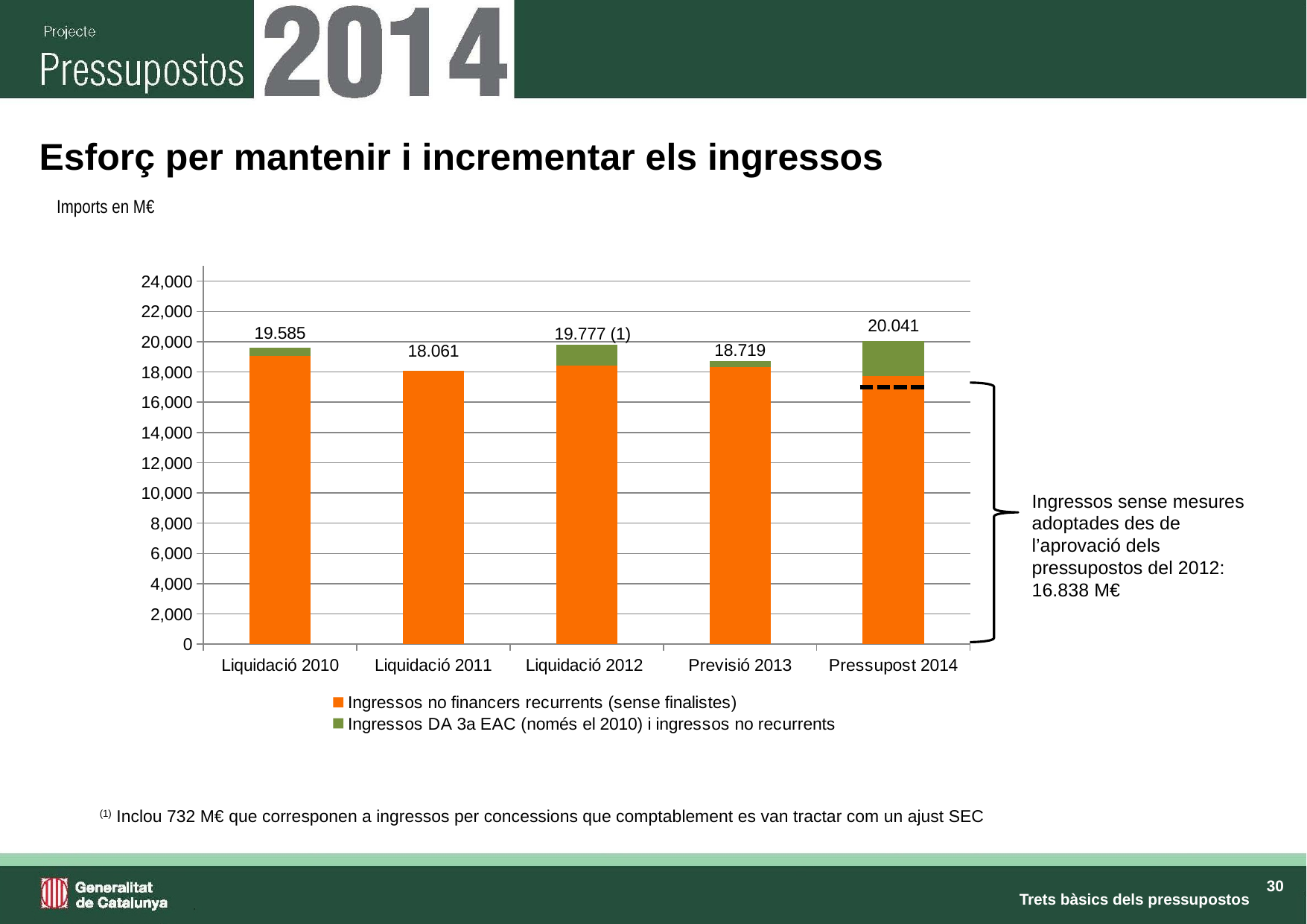
What is the difference between the totals for Pressupost 2014 and Liquidació 2010? 456 How many series does the legend list? 2 Which category has the highest total value? Pressupost 2014 Does the total value rise or fall from Previsió 2013 to Pressupost 2014? rise Which is larger, the total for Liquidació 2010 or the total for Previsió 2013? Liquidació 2010 What is the total value shown for Liquidació 2011? 18.061 Is the value of the orange segment (Ingressos no financers recurrents) for Pressupost 2014 greater or less than 18,000? less How many categories are shown on the x axis? 5 Which category has the lowest total value? Liquidació 2011 What kind of chart is shown on the slide? Stacked bar chart What is the total value shown for Previsió 2013? 18.719 What is the total value shown for Pressupost 2014? 20.041